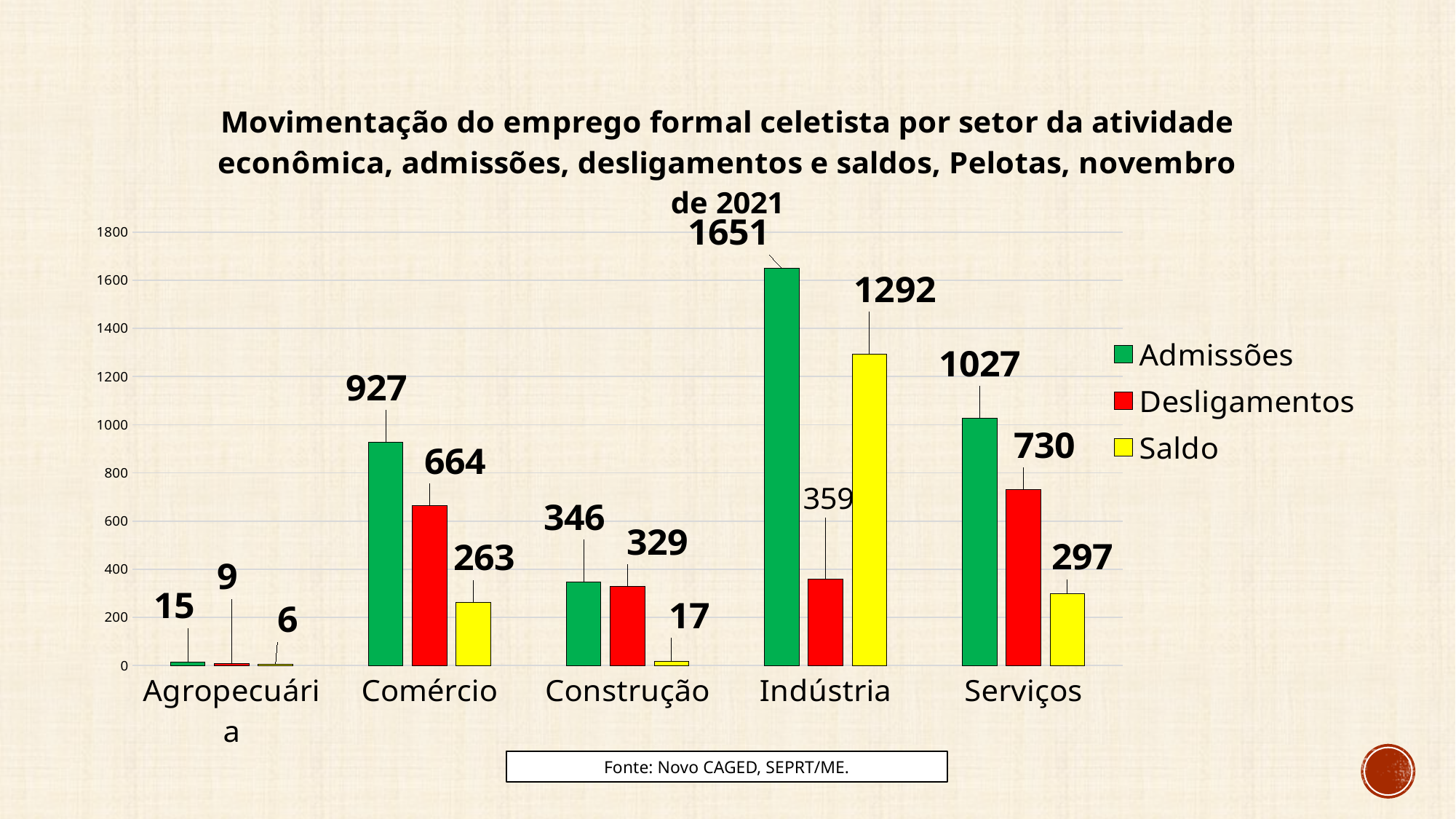
How many series does the legend list? 3 How many sectors are shown on the x axis? 5 Which is larger for Indústria: Desligamentos or Saldo? Saldo What colour are the Saldo bars? yellow Which sector has the highest Admissões value? Indústria What is the difference between Admissões and Desligamentos for Serviços? 297 Is the Admissões value for Comércio greater or less than 800? greater What is the value of Desligamentos for Comércio? 664 What kind of chart is shown on the slide? bar chart What is the value of Admissões for Indústria? 1651 Which sector has the lowest Saldo value? Agropecuária What is the value of Saldo for Construção? 17